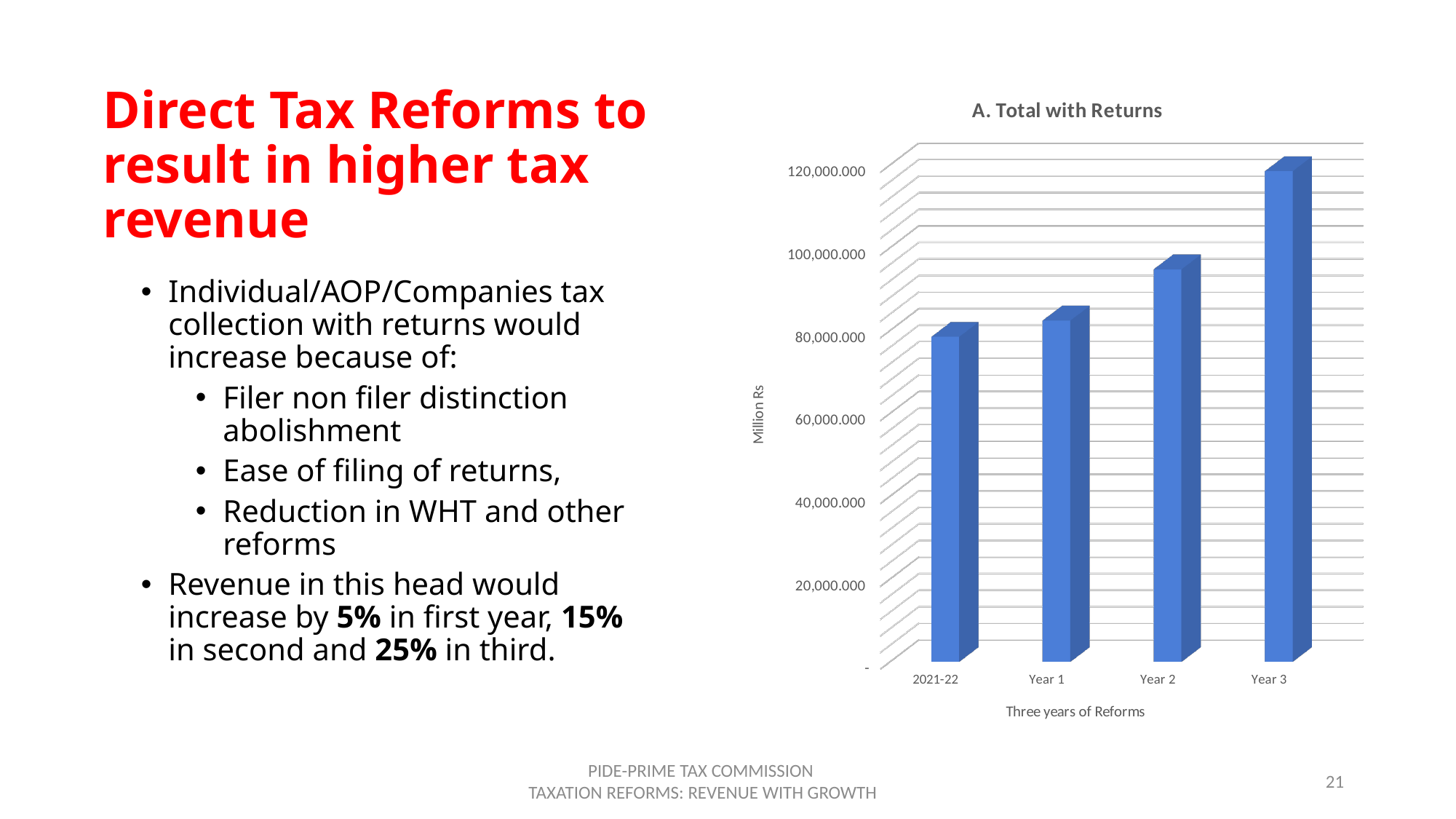
Which category has the highest value in the chart? Year 3 What unit is shown on the vertical axis label of the chart? Million Rs Which is larger, the value for Year 2 or the value for Year 1? Year 2 What kind of chart is shown on the slide? Bar chart Is the value for 2021-22 greater or less than 60,000.000? greater Is the value for Year 2 greater or less than 100,000.000? less Which category has the lowest value in the chart? 2021-22 Do the values rise or fall from 2021-22 to Year 3? Rise How many categories are plotted on the x axis of the chart? 4 Is the value for Year 3 greater or less than 100,000.000? greater What is the title of the chart? A. Total with Returns